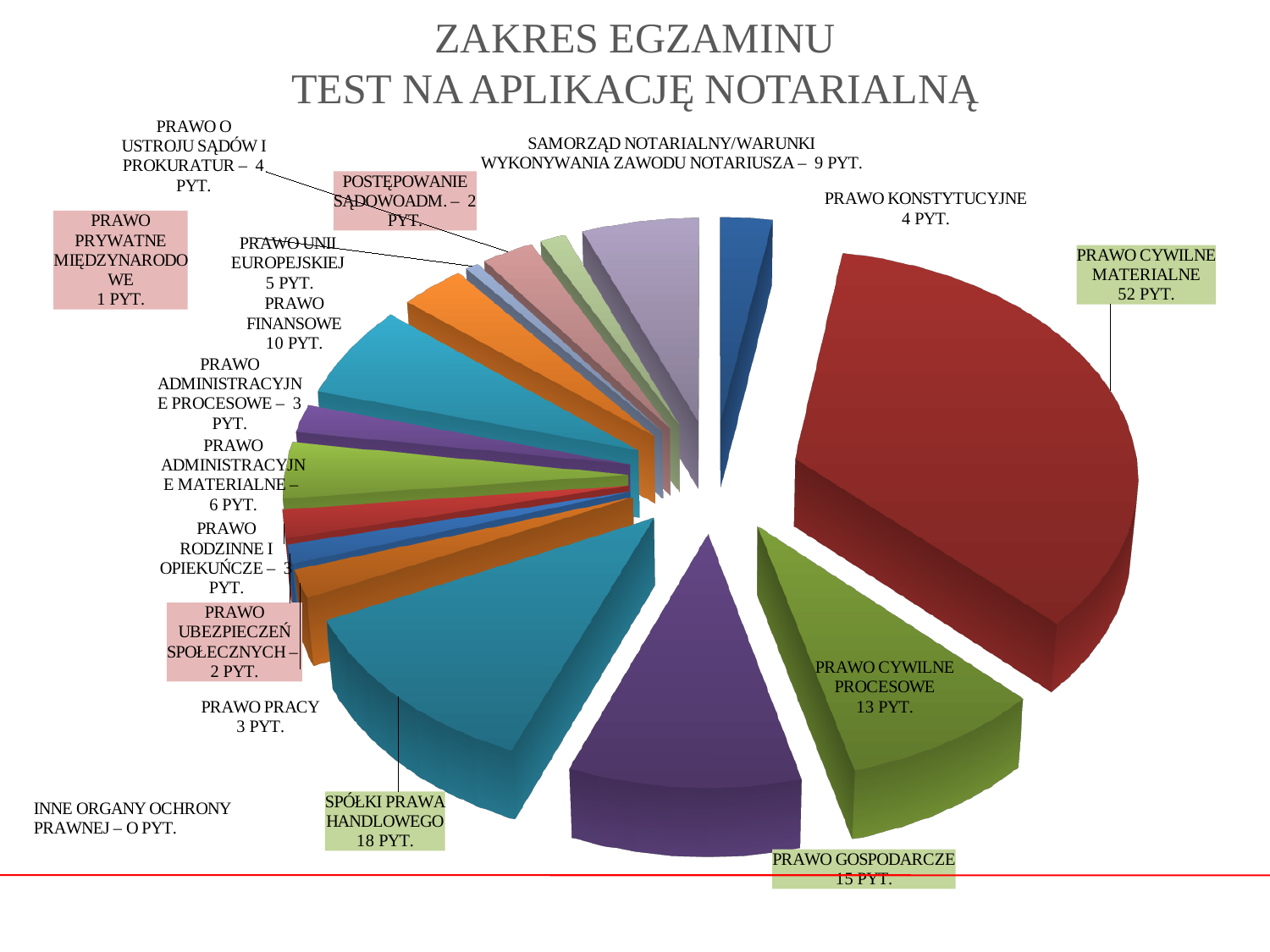
What is the difference in questions between PRAWO CYWILNE MATERIALNE and SPÓŁKI PRAWA HANDLOWEGO? 34 Which category is labelled with 0 questions? INNE ORGANY OCHRONY PRAWNEJ Which has more questions, PRAWO ADMINISTRACYJNE MATERIALNE or PRAWO ADMINISTRACYJNE PROCESOWE? PRAWO ADMINISTRACYJNE MATERIALNE How many questions are listed for SAMORZĄD NOTARIALNY/WARUNKI WYKONYWANIA ZAWODU NOTARIUSZA? 9 PYT. How many questions are allocated to SPÓŁKI PRAWA HANDLOWEGO? 18 PYT. How many questions does PRAWO FINANSOWE have? 10 PYT. How many questions (PYT.) does PRAWO CYWILNE MATERIALNE have on the pie chart? 52 PYT. Which category has the largest number of questions on the chart? PRAWO CYWILNE MATERIALNE How many questions does PRAWO GOSPODARCZE have? 15 PYT. What type of chart is shown on the slide? Pie chart What is the difference in questions between PRAWO GOSPODARCZE and PRAWO CYWILNE PROCESOWE? 2 Which has more questions, PRAWO FINANSOWE or PRAWO UNII EUROPEJSKIEJ? PRAWO FINANSOWE